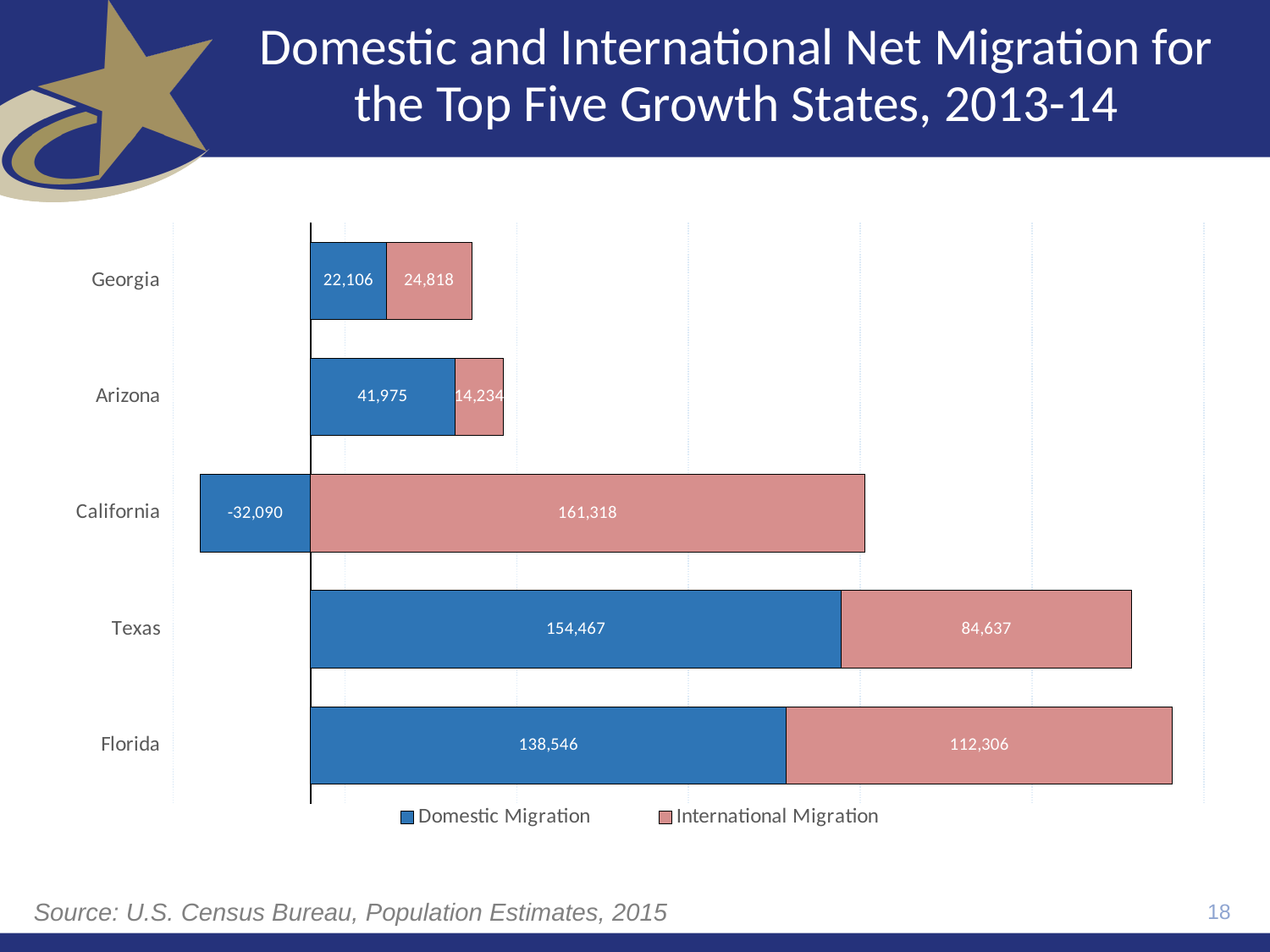
Which state has the lowest International Migration value? Arizona How many states are shown in the chart? 5 How many series does the legend list? 2 What is the Domestic Migration value for Texas? 154,467 Which state has the highest Domestic Migration value? Texas Which is larger, the International Migration value for Florida or for Texas? Florida What is the International Migration value for California? 161,318 What is the Domestic Migration value for California? -32,090 What kind of chart is shown on the slide? Stacked bar chart What is the total of Domestic Migration and International Migration for Florida? 250,852 What is the International Migration value for Arizona? 14,234 What is the difference between the Domestic Migration values for Texas and Florida? 15,921